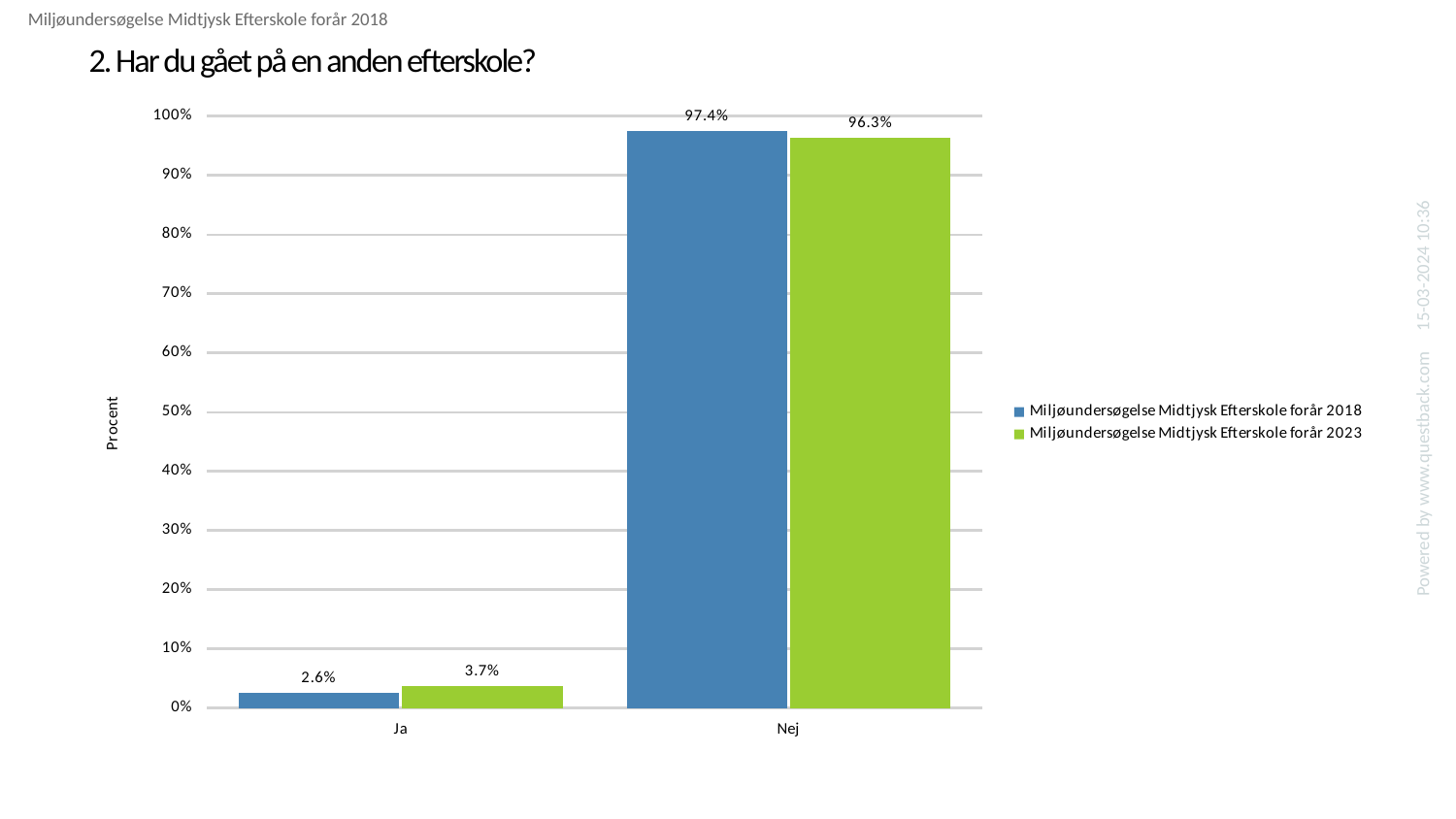
How many series does the legend list? 2 Which series has the larger value for "Ja", 2018 or 2023? 2023 What is the value for "Nej" in the Miljøundersøgelse Midtjysk Efterskole forår 2023 series? 96.3% What is the value for "Nej" in the Miljøundersøgelse Midtjysk Efterskole forår 2018 series? 97.4% Is the value for "Nej" in the 2018 series greater or less than 90%? greater What is the value for "Ja" in the Miljøundersøgelse Midtjysk Efterskole forår 2018 series? 2.6% Which category has the lowest value in the Miljøundersøgelse Midtjysk Efterskole forår 2023 series? Ja How many categories are shown on the x axis? 2 What is the value for "Ja" in the Miljøundersøgelse Midtjysk Efterskole forår 2023 series? 3.7% What is the difference between the "Nej" values for the 2018 and 2023 series? 1.1% Which category has the highest value in the Miljøundersøgelse Midtjysk Efterskole forår 2018 series? Nej What kind of chart is shown on the slide? bar chart